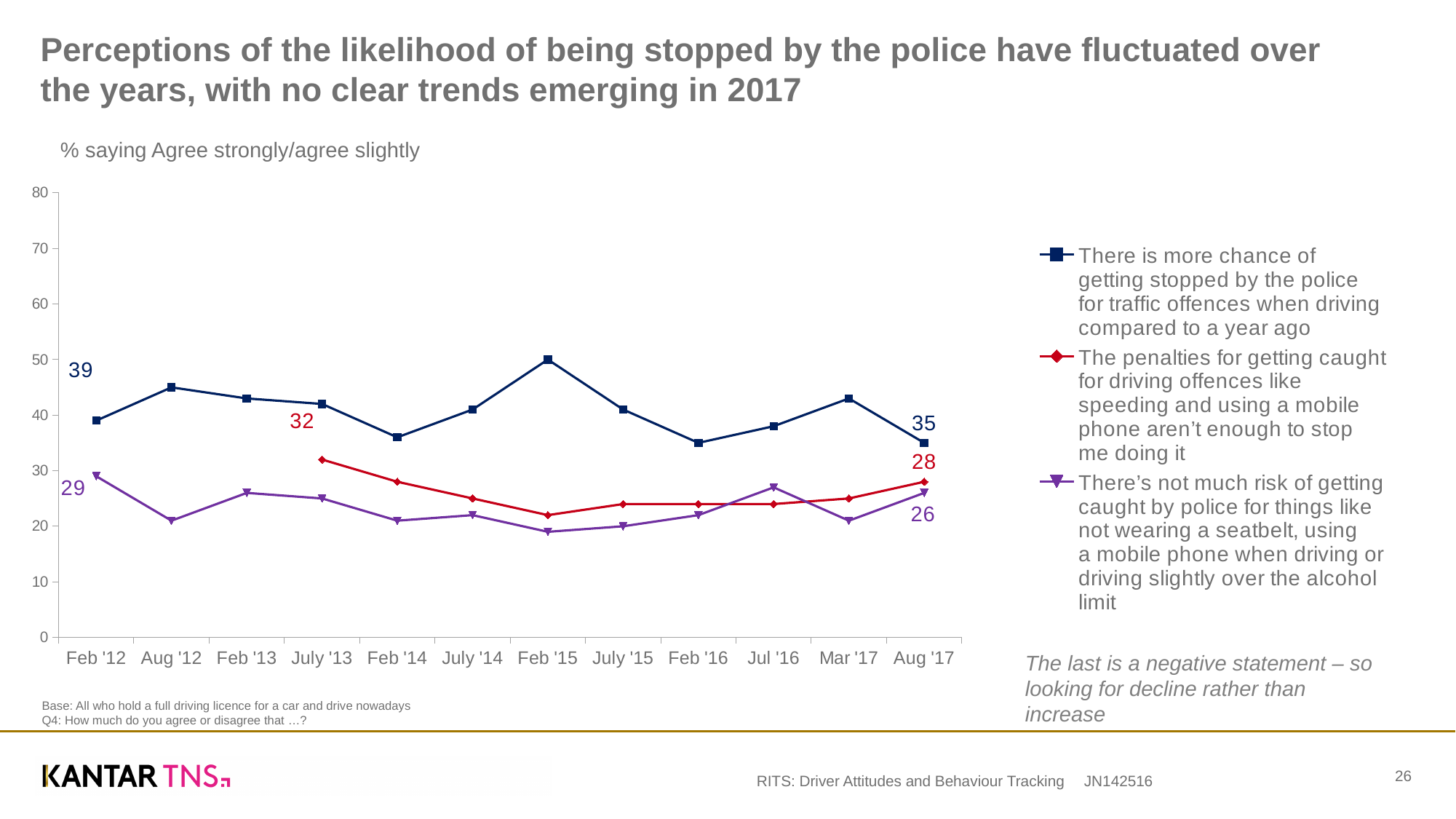
How many time points are shown on the x axis? 12 Is the value for 'There is more chance of getting stopped by the police...' in Feb '15 greater or less than 40? greater In Aug '17, how much higher is 'There is more chance of getting stopped by the police...' than 'The penalties for getting caught... aren't enough to stop me doing it'? 7 What is the value for 'There's not much risk of getting caught by police...' in Aug '17? 26 How many series does the legend list? 3 At which time point does 'There is more chance of getting stopped by the police...' reach its highest value? Feb '15 In Aug '17, which is larger: the value for 'There is more chance of getting stopped by the police...' or the value for 'There's not much risk of getting caught by police...'? There is more chance of getting stopped by the police... What is the value for 'There is more chance of getting stopped by the police for traffic offences when driving compared to a year ago' in Aug '17? 35 What is the value for 'There is more chance of getting stopped by the police for traffic offences when driving compared to a year ago' in Feb '12? 39 What is the value for 'The penalties for getting caught for driving offences like speeding and using a mobile phone aren't enough to stop me doing it' in July '13? 32 What is the difference between the Feb '12 and Aug '17 values for 'There is more chance of getting stopped by the police...'? 4 What kind of chart is shown on the slide? line chart